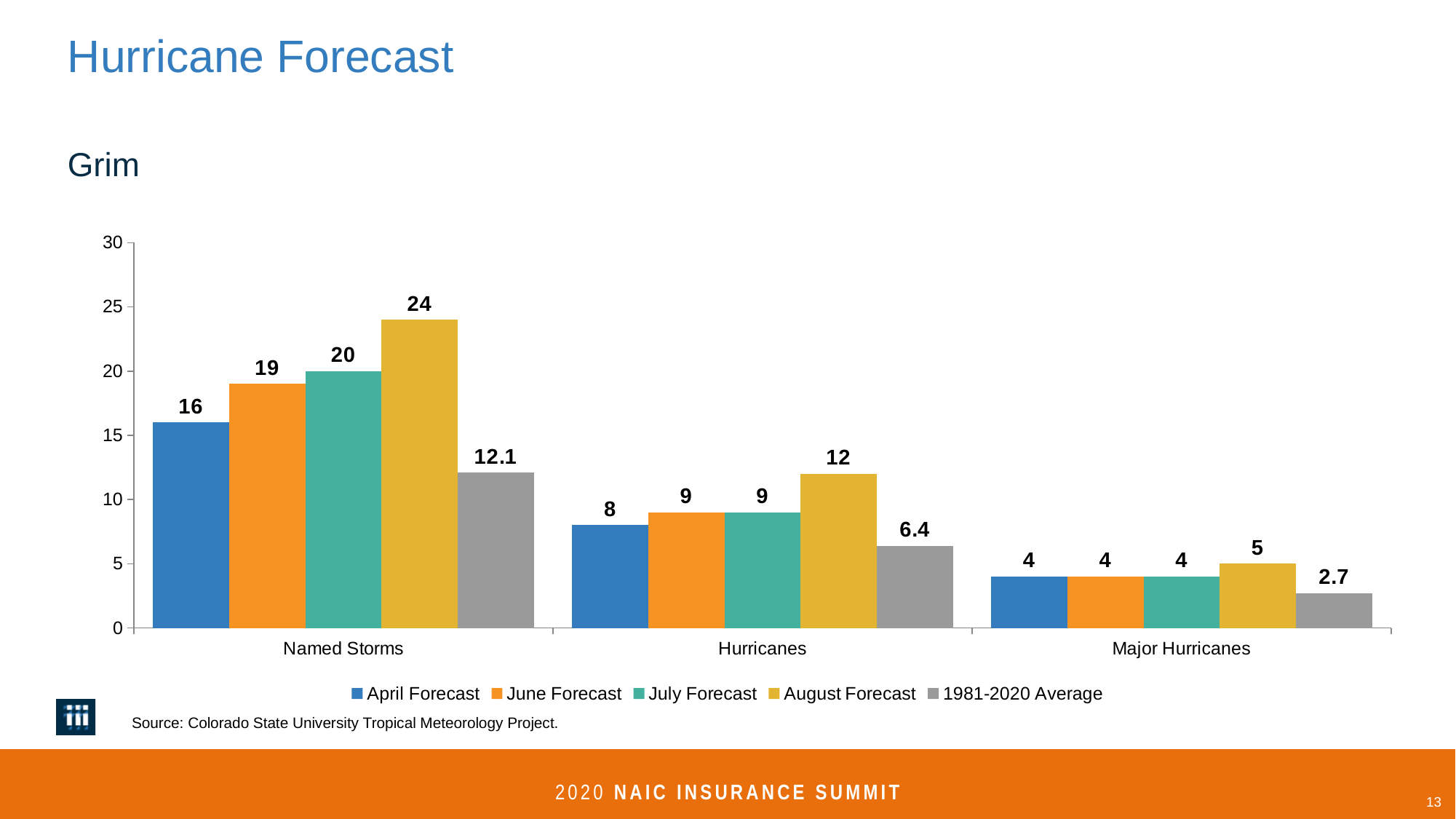
What is the 1981-2020 Average value for Hurricanes? 6.4 What is the difference between the August Forecast and the April Forecast for Named Storms? 8 What kind of chart is shown on the slide? Bar chart How many series does the legend list? 5 What colour are the August Forecast bars? Yellow Which series has the highest value for Named Storms? August Forecast What is the April Forecast value for Major Hurricanes? 4 Which series has the lowest value for Hurricanes? 1981-2020 Average What is the difference between the August Forecast and the 1981-2020 Average for Hurricanes? 5.6 How many categories are shown on the x axis? 3 What is the August Forecast value for Named Storms? 24 Which is larger for Hurricanes: the June Forecast or the April Forecast? June Forecast